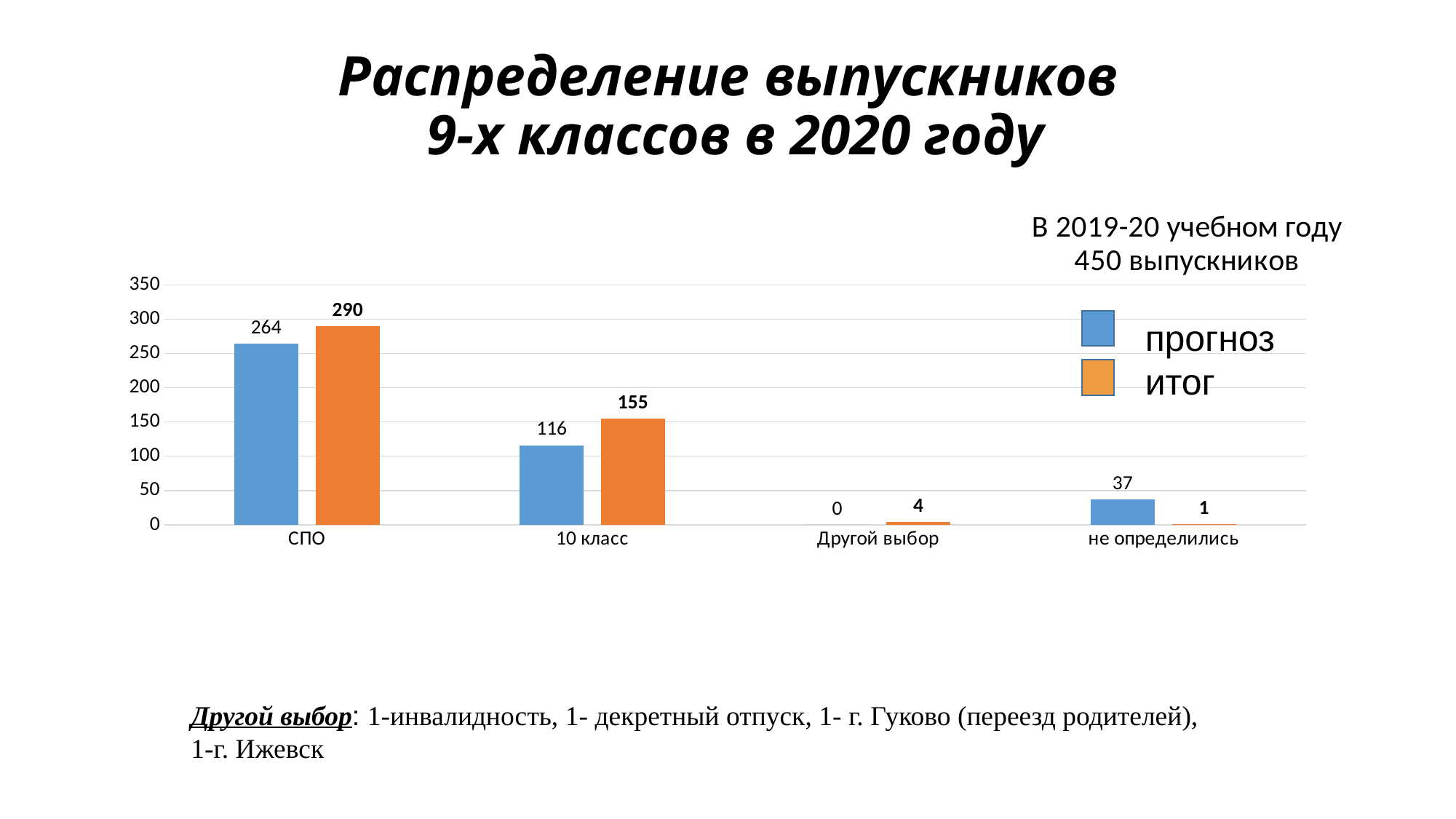
How many categories are shown on the x axis? 4 What is the прогноз value for СПО? 264 What kind of chart is shown on the slide? bar chart What is the difference between the итог and прогноз values for СПО? 26 What is the прогноз value for не определились? 37 Which category has the highest итог value? СПО What is the итог value for Другой выбор? 4 What is the итог value for 10 класс? 155 Which is larger for 10 класс: прогноз or итог? итог Which colour represents the итог series in the legend? orange Which category has the lowest прогноз value? Другой выбор How many series does the legend list? 2